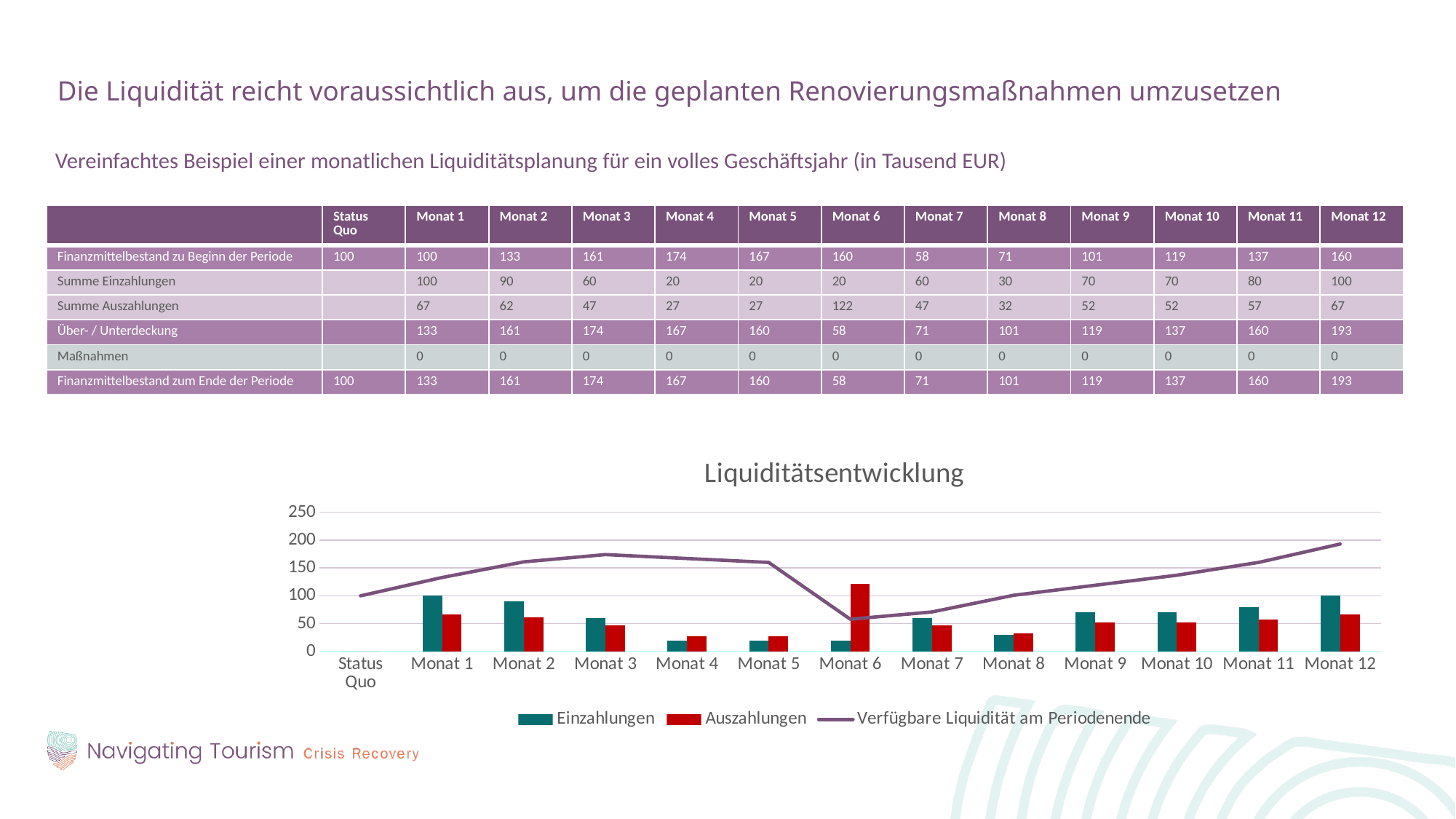
What kind of chart is the 'Liquiditätsentwicklung' chart? A combined bar and line chart In the 'Liquiditätsentwicklung' chart, is the value of Auszahlungen for Monat 6 greater or less than 100? greater In the 'Liquiditätsentwicklung' chart, is the value of Einzahlungen for Monat 8 greater or less than 50? less In the 'Liquiditätsentwicklung' chart, which is larger for Monat 6: Einzahlungen or Auszahlungen? Auszahlungen In the 'Liquiditätsentwicklung' chart, in which month are the Auszahlungen highest? Monat 6 In the 'Liquiditätsentwicklung' chart, at which month does the 'Verfügbare Liquidität am Periodenende' line reach its highest point? Monat 12 How many series does the legend of the 'Liquiditätsentwicklung' chart list? 3 In the 'Liquiditätsentwicklung' chart, does the 'Verfügbare Liquidität am Periodenende' line rise or fall from Monat 6 to Monat 12? rise In the 'Liquiditätsentwicklung' chart, what is the value of Einzahlungen for Monat 1? 100 In the 'Liquiditätsentwicklung' chart, at which month does the 'Verfügbare Liquidität am Periodenende' line reach its lowest point? Monat 6 How many categories are shown on the x axis of the 'Liquiditätsentwicklung' chart? 13 In the 'Liquiditätsentwicklung' chart, what is the value of the 'Verfügbare Liquidität am Periodenende' line at Status Quo? 100